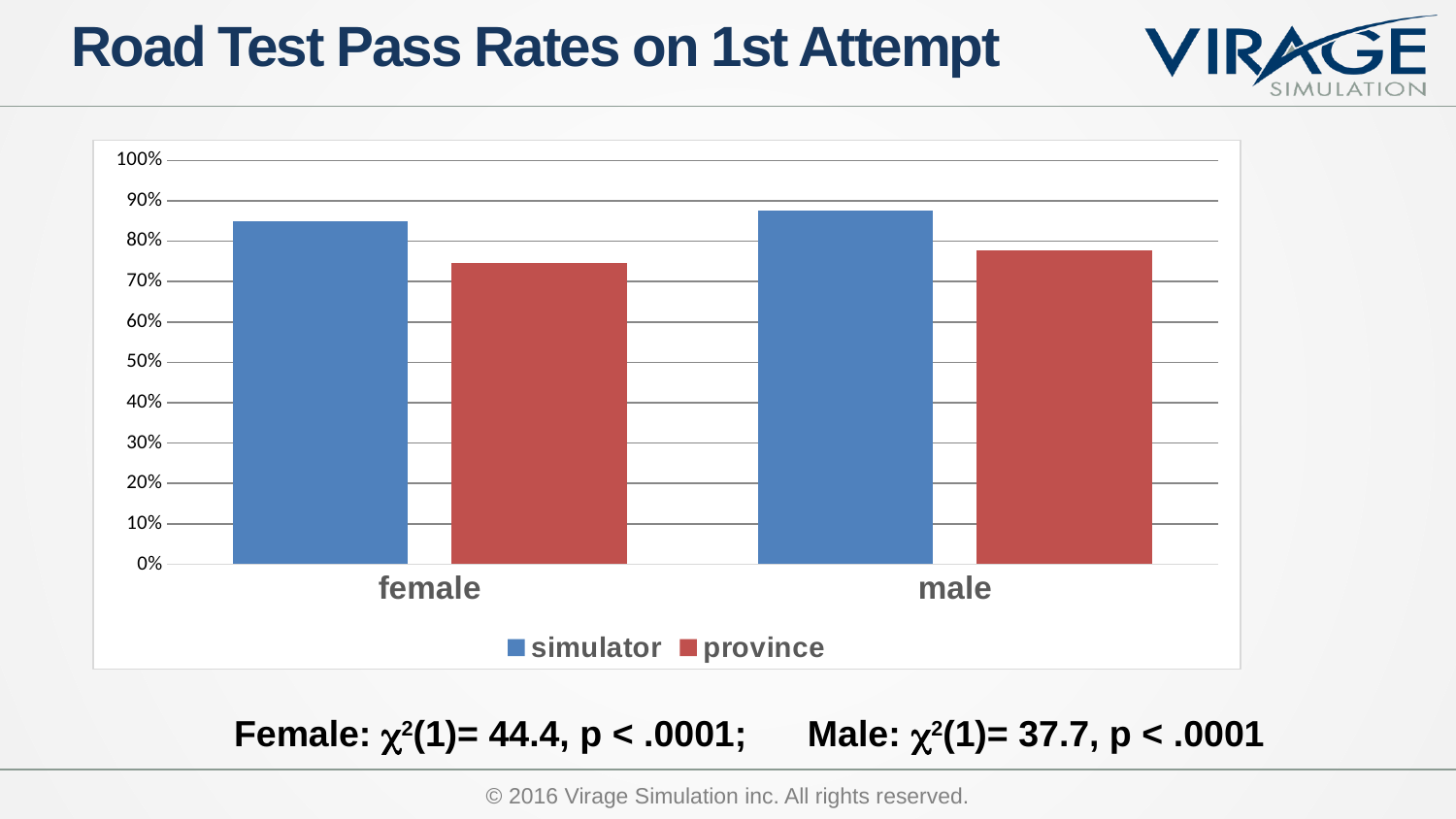
For male, which is larger: the simulator value or the province value? simulator Is the province value for male greater or less than 80%? less Is the simulator value for female greater or less than 80%? greater How many categories are shown on the x axis? 2 For female, which is larger: the simulator value or the province value? simulator What kind of chart is shown on the slide? bar chart Is the simulator value for male greater or less than 90%? less What is the title of the slide containing the chart? Road Test Pass Rates on 1st Attempt How many series does the legend list? 2 Which series is shown in red in the chart? province